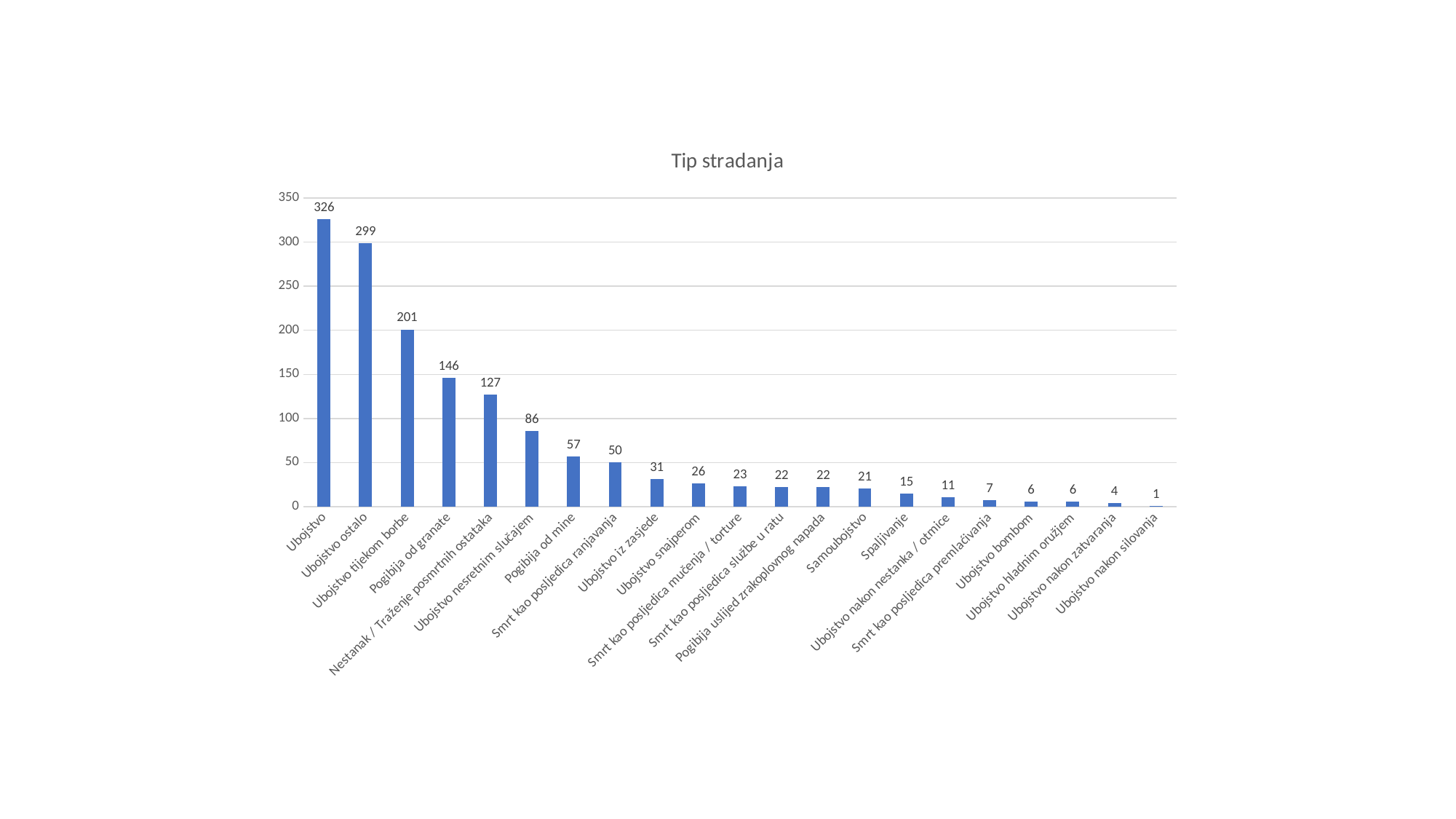
Which category has the highest value? Ubojstvo How many categories are shown on the x axis? 21 Which category has the lowest value? Ubojstvo nakon silovanja What is the title of the chart? Tip stradanja What is the difference between the values for Ubojstvo and Ubojstvo ostalo? 27 Is the value for Ubojstvo nesretnim slučajem greater or less than 100? less What is the value for Pogibija od mine? 57 What kind of chart is shown on the slide? bar chart Which is larger, the value for Ubojstvo iz zasjede or the value for Spaljivanje? Ubojstvo iz zasjede What is the difference between the values for Pogibija od granate and Nestanak / Traženje posmrtnih ostataka? 19 What is the value for Samoubojstvo? 21 What is the value for Ubojstvo tijekom borbe? 201